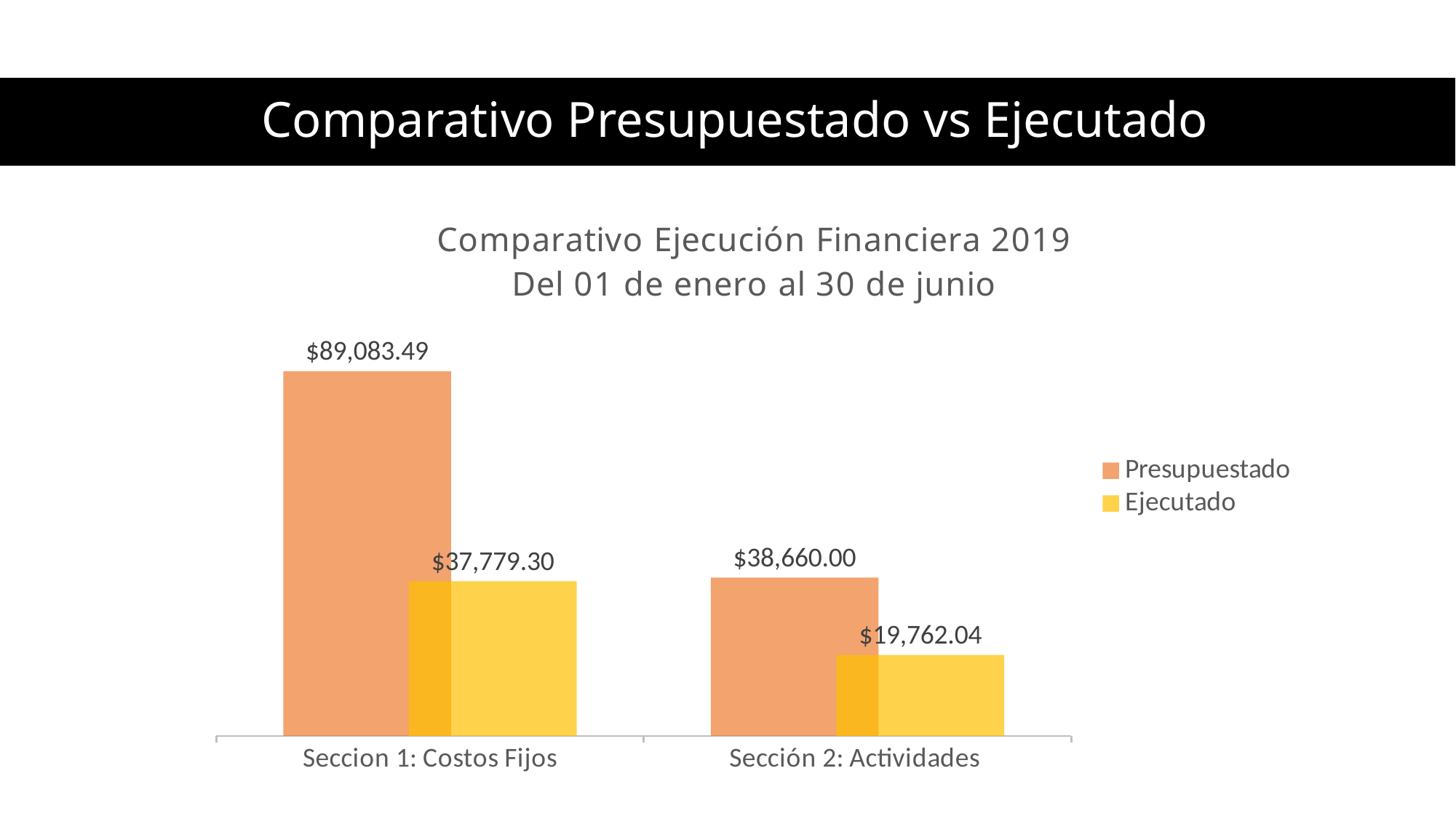
Which category has the lowest Ejecutado value? Sección 2: Actividades What is the Ejecutado value for Sección 2: Actividades? $19,762.04 What is the Ejecutado value for Seccion 1: Costos Fijos? $37,779.30 What is the Presupuestado value for Sección 2: Actividades? $38,660.00 What is the Presupuestado value for Seccion 1: Costos Fijos? $89,083.49 Which is larger: the Ejecutado value for Seccion 1: Costos Fijos or the Presupuestado value for Sección 2: Actividades? Presupuestado for Sección 2: Actividades How many categories are shown on the x axis? 2 What is the difference between the Presupuestado and Ejecutado values for Sección 2: Actividades? $18,897.96 What is the difference between the Presupuestado and Ejecutado values for Seccion 1: Costos Fijos? $51,304.19 How many series does the legend list? 2 What kind of chart is shown on the slide? Bar chart Which category has the highest Presupuestado value? Seccion 1: Costos Fijos